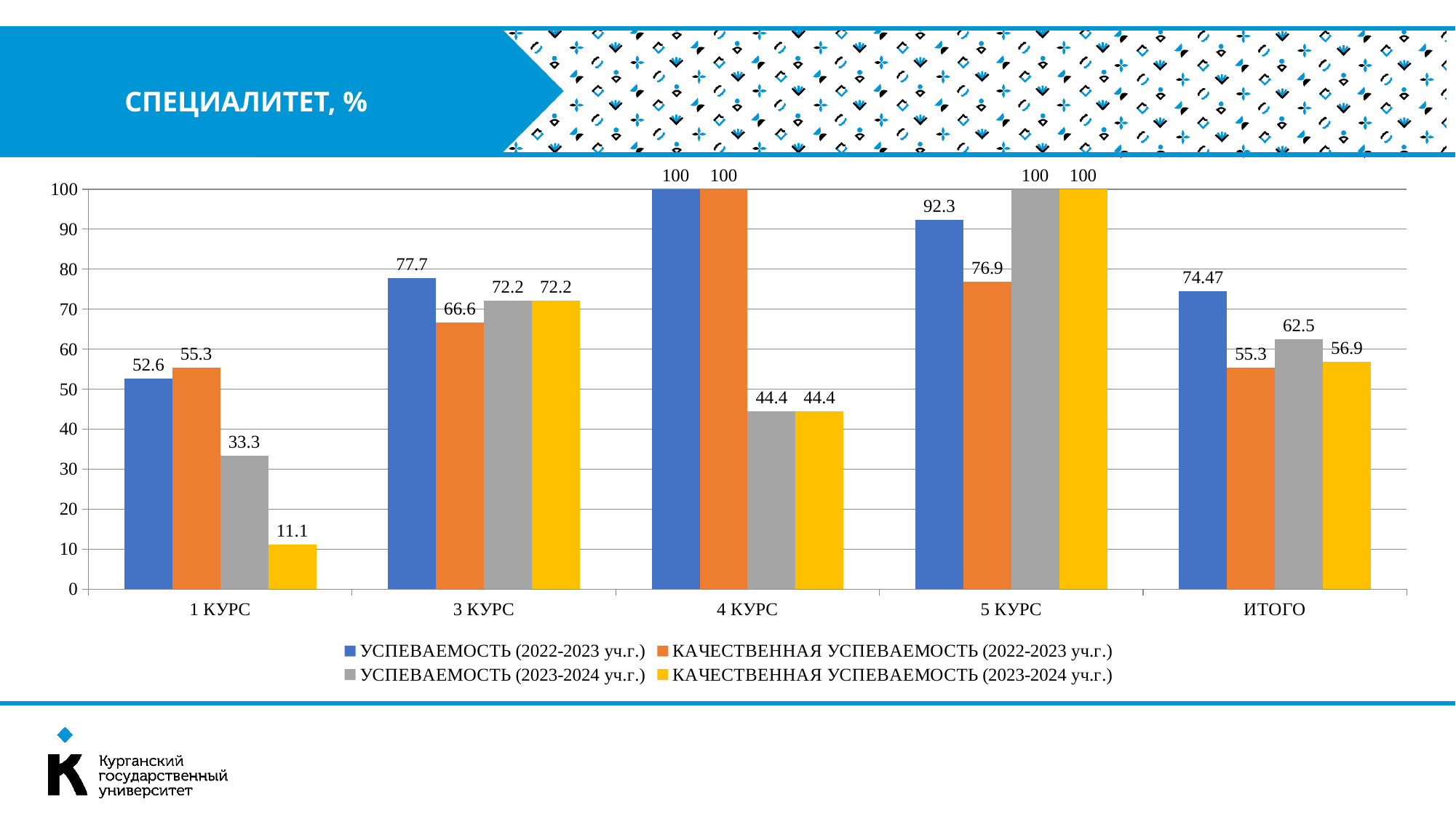
How many categories are shown on the x axis? 5 Which is larger for 4 КУРС: УСПЕВАЕМОСТЬ (2022-2023 уч.г.) or УСПЕВАЕМОСТЬ (2023-2024 уч.г.)? УСПЕВАЕМОСТЬ (2022-2023 уч.г.) What kind of chart is shown on the slide? bar chart How many series does the legend list? 4 Is the value of УСПЕВАЕМОСТЬ (2022-2023 уч.г.) for 5 КУРС greater or less than 90? greater What is the value of КАЧЕСТВЕННАЯ УСПЕВАЕМОСТЬ (2022-2023 уч.г.) for 5 КУРС? 76.9 Which category has the highest value for УСПЕВАЕМОСТЬ (2022-2023 уч.г.)? 4 КУРС What is the value of УСПЕВАЕМОСТЬ (2022-2023 уч.г.) for 1 КУРС? 52.6 What is the value of УСПЕВАЕМОСТЬ (2023-2024 уч.г.) for ИТОГО? 62.5 What is the value of КАЧЕСТВЕННАЯ УСПЕВАЕМОСТЬ (2023-2024 уч.г.) for 1 КУРС? 11.1 What is the difference between УСПЕВАЕМОСТЬ (2022-2023 уч.г.) and УСПЕВАЕМОСТЬ (2023-2024 уч.г.) for 1 КУРС? 19.3 Which category has the lowest value for КАЧЕСТВЕННАЯ УСПЕВАЕМОСТЬ (2023-2024 уч.г.)? 1 КУРС